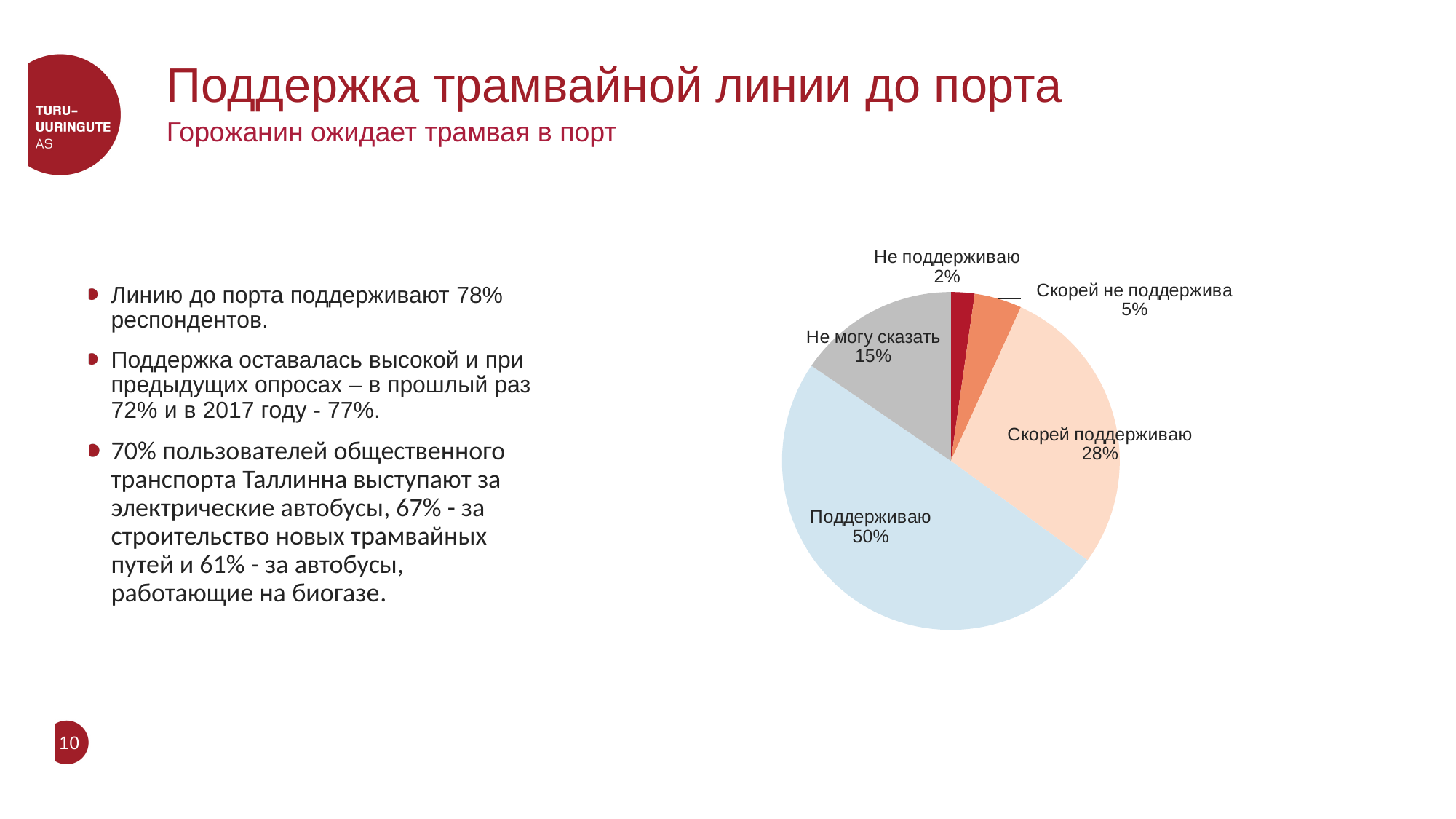
What colour is the "Поддерживаю" slice? light blue Which slice of the pie is the smallest? Не поддерживаю What share of respondents answered "Не поддерживаю"? 2% What share of respondents answered "Скорей поддерживаю"? 28% Which is larger: the share for "Не могу сказать" or the share for "Скорей не поддерживаю"? Не могу сказать Which slice of the pie is the largest? Поддерживаю What is the difference in percentage points between "Поддерживаю" and "Скорей поддерживаю"? 22 How many slices does the pie chart have? 5 What share of respondents answered "Скорей не поддерживаю"? 5% What share of respondents answered "Не могу сказать"? 15% What share of respondents answered "Поддерживаю"? 50% What kind of chart is shown on the slide? pie chart